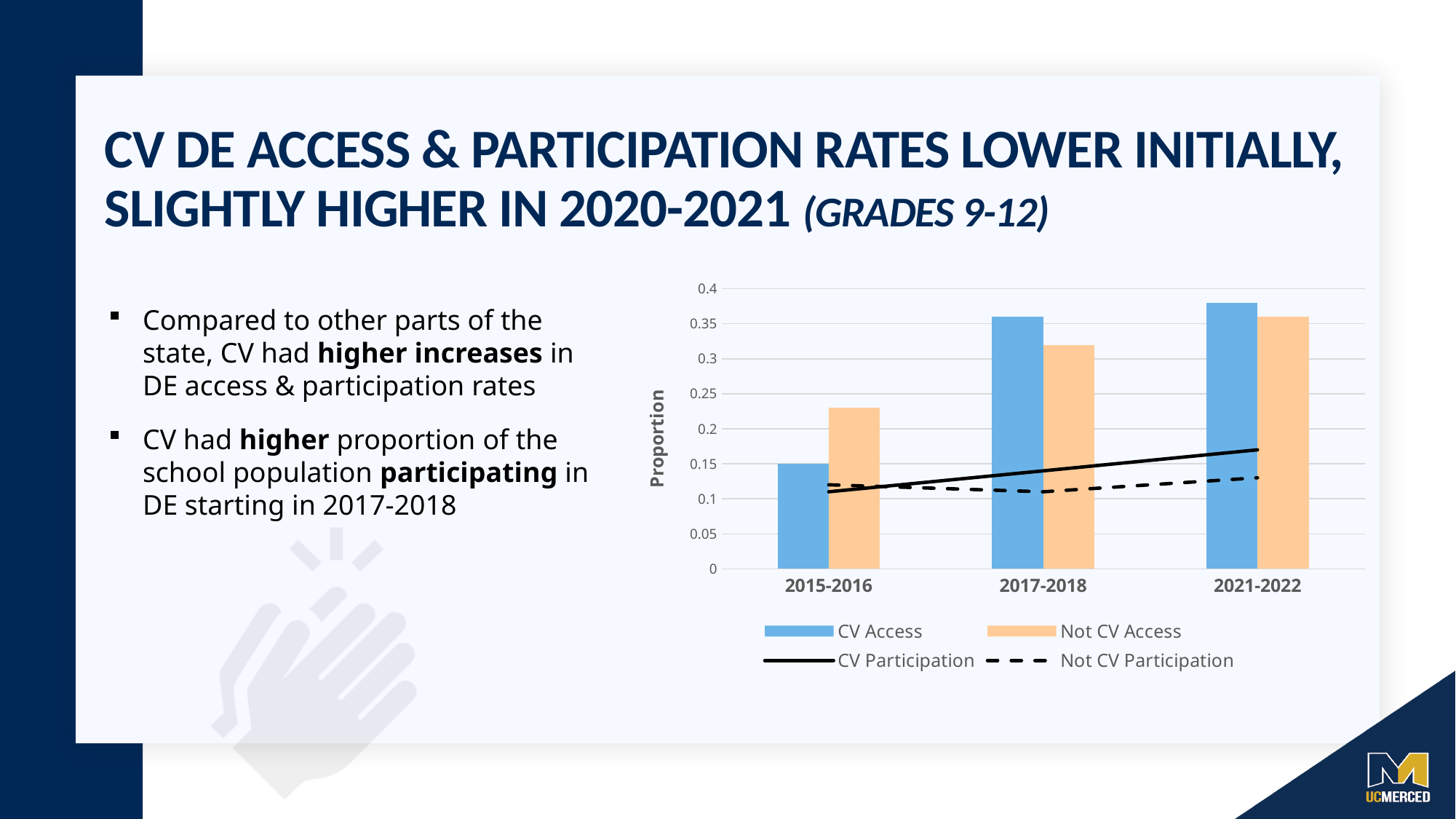
Which school year has the highest CV Access bar? 2021-2022 What kind of chart is shown on the slide? A combined bar and line chart What is the label on the vertical axis of the chart? Proportion How many school-year categories are shown on the x axis? 3 Which school year has the lowest CV Access bar? 2015-2016 Is the CV Access value for 2017-2018 greater or less than 0.3? greater How many series does the legend list? 4 Which school year has the lowest Not CV Access bar? 2015-2016 Is the Not CV Access value for 2015-2016 greater or less than 0.25? less Does the CV Participation line rise or fall from 2015-2016 to 2021-2022? Rises In 2015-2016, which is larger: CV Access or Not CV Access? Not CV Access In 2017-2018, which is larger: CV Access or Not CV Access? CV Access